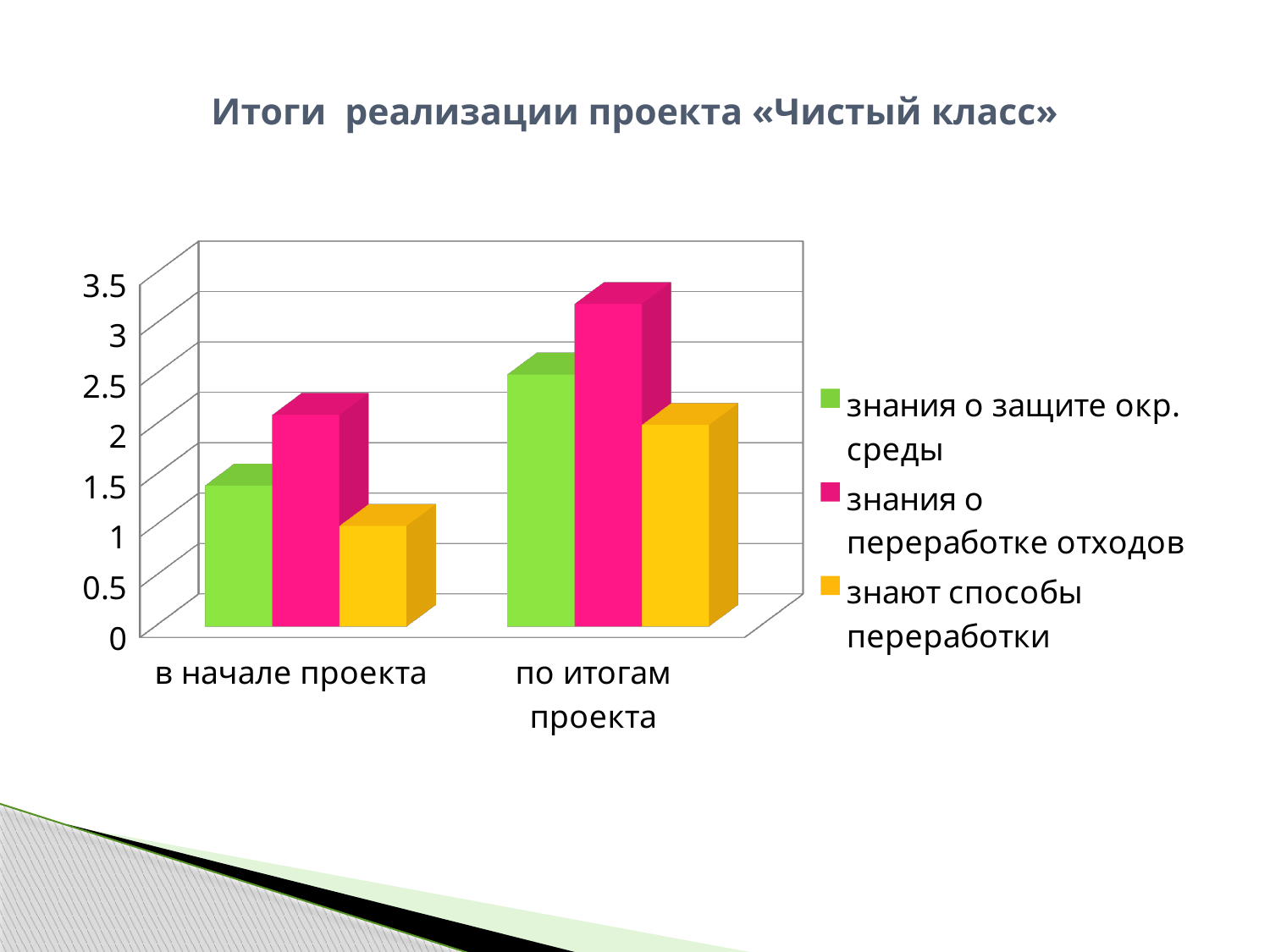
What is the title of the slide containing the chart? Итоги реализации проекта «Чистый класс» Which series has the lowest value in the "в начале проекта" category? знают способы переработки Which is larger: "знания о переработке отходов" or "знают способы переработки" in the "по итогам проекта" category? знания о переработке отходов Do the values for "знания о защите окр. среды" rise or fall from "в начале проекта" to "по итогам проекта"? rise Is the value for "знают способы переработки" in "по итогам проекта" greater or less than 1.5? greater How many categories are shown on the x axis? 2 Is the value for "знания о защите окр. среды" in "по итогам проекта" greater or less than 2? greater Which series has the highest value in the "по итогам проекта" category? знания о переработке отходов What kind of chart is shown on the slide? bar chart Is the value for "знания о переработке отходов" in "по итогам проекта" greater or less than 3? greater How many series does the legend list? 3